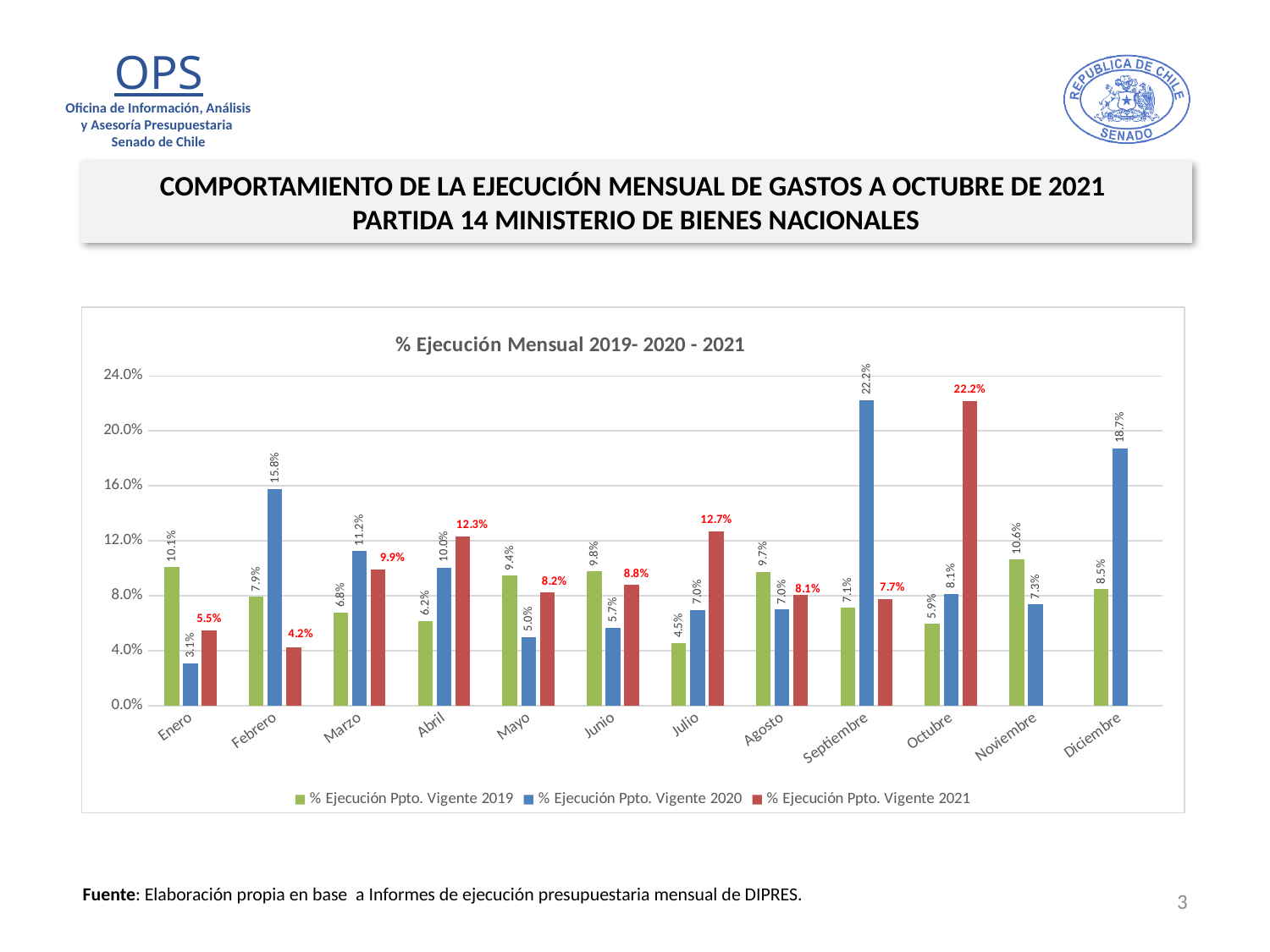
How many months are shown on the x axis? 12 Which is larger for Abril: the 2020 value or the 2021 value? 2021 value What is the value of % Ejecución Ppto. Vigente 2019 for Noviembre? 10.6% In which month is % Ejecución Ppto. Vigente 2020 highest? Septiembre What is the title of the chart? % Ejecución Mensual 2019- 2020 - 2021 What is the value of % Ejecución Ppto. Vigente 2021 for Octubre? 22.2% What is the difference between the 2021 and 2019 values for Julio? 8.2% What is the value of % Ejecución Ppto. Vigente 2020 for Febrero? 15.8% How many series does the legend list? 3 In which month is % Ejecución Ppto. Vigente 2019 lowest? Julio What type of chart is shown on the slide? bar chart Is the value of % Ejecución Ppto. Vigente 2020 for Diciembre greater or less than 16.0%? greater